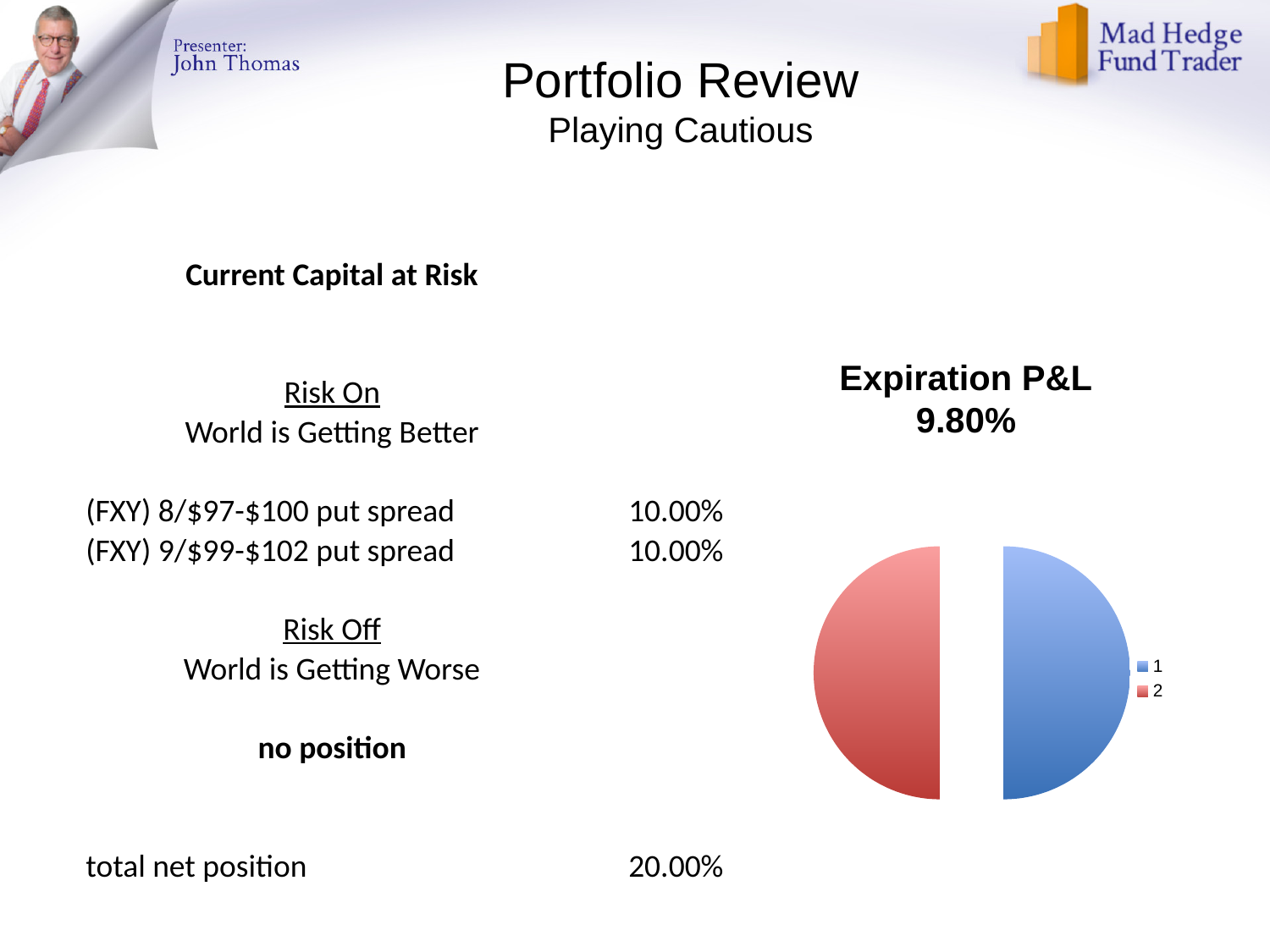
What percentage is shown in the title of the pie chart? 9.80% How many slices does the pie chart have? 2 How many entries does the pie chart's legend list? 2 What is the title of the pie chart? Expiration P&L 9.80% What kind of chart is shown on the slide? pie chart What are the legend entries of the pie chart? 1 and 2